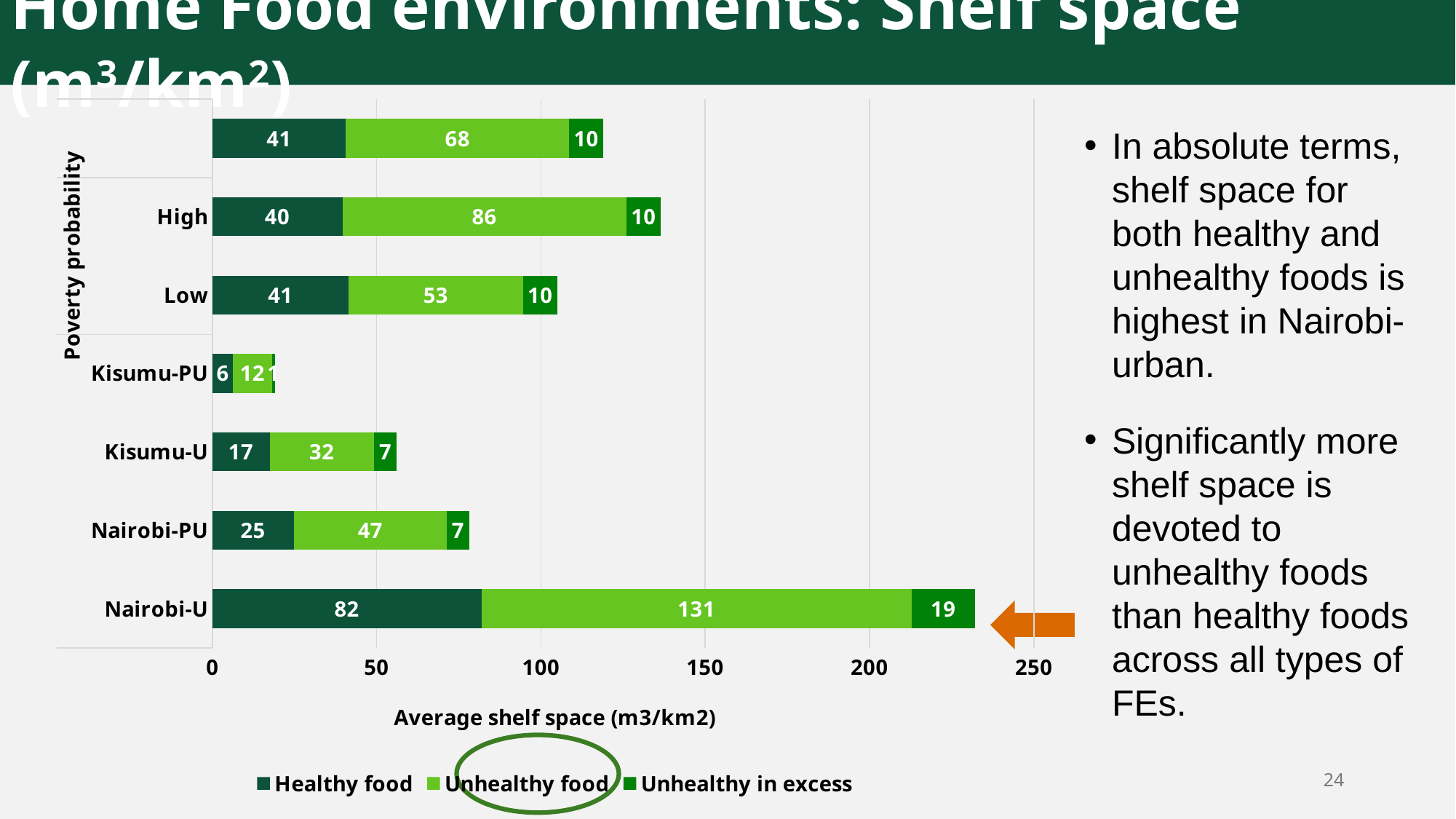
What is the Unhealthy in excess value for Kisumu-U? 7 What is the Unhealthy food value for High poverty probability? 86 What is the Healthy food value for Nairobi-U? 82 Which is larger, the Unhealthy food value for Low or for Kisumu-U? Low Which category has the highest Unhealthy food value? Nairobi-U Is the total for the Nairobi-U bar greater or less than 200? greater What is the difference between the Unhealthy food values for Nairobi-U and Nairobi-PU? 84 Which category has the lowest Healthy food value? Kisumu-PU What is the x-axis title of the chart? Average shelf space (m3/km2) What is the total shelf space for the Nairobi-U bar? 232 What type of chart is shown on the slide? Stacked bar chart How many series does the legend list? 3